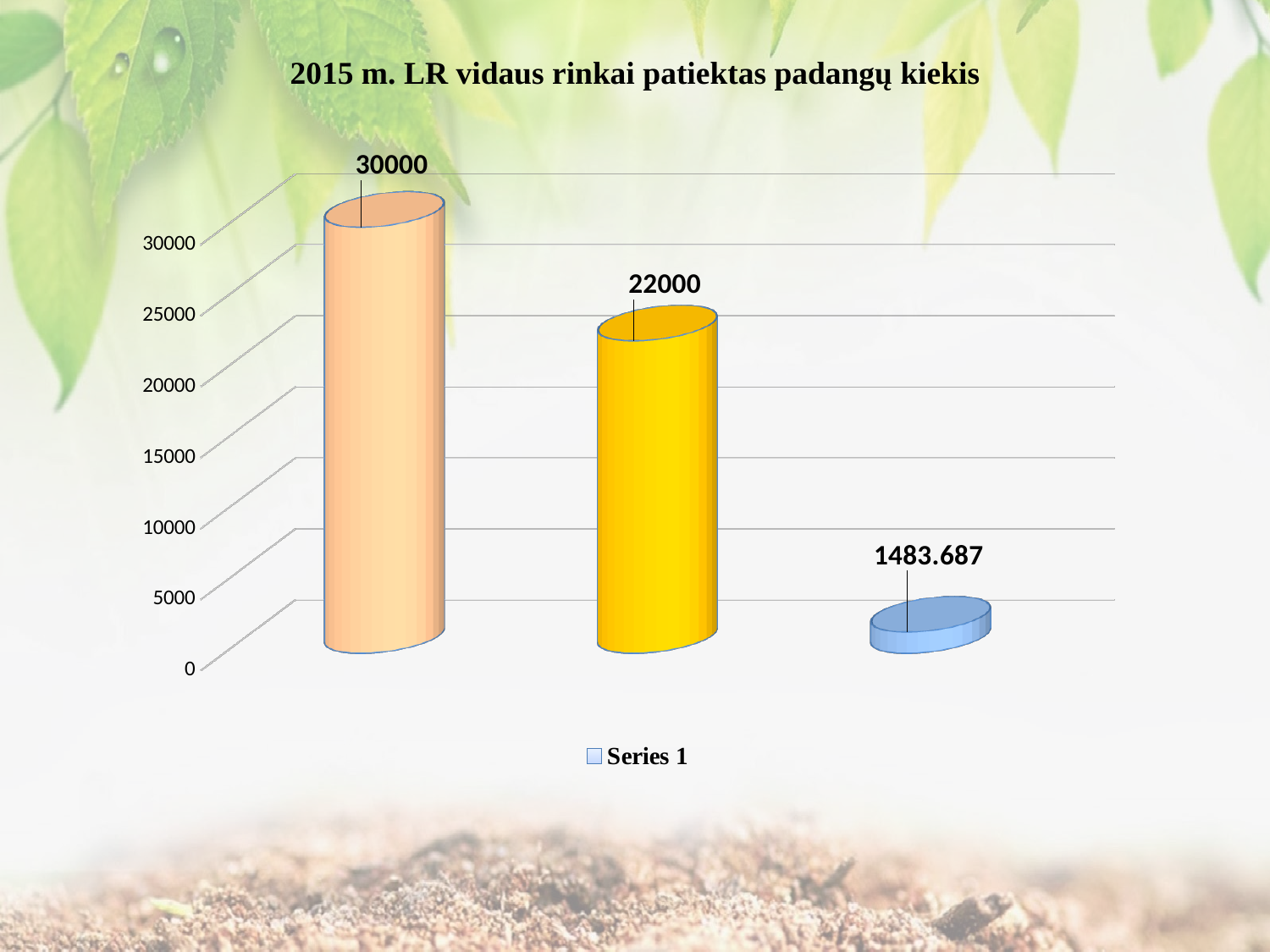
What is the value shown on the rightmost bar of the chart? 1483.687 Which is larger, the value of the middle bar or the value of the right bar? the middle bar Which bar has the highest value: the left, middle or right one? the left one Do the bar values rise or fall from left to right? fall What is the value shown on the leftmost bar of the chart? 30000 What is the difference between the values of the middle bar and the right bar? 20516.313 How many bars are plotted in the chart? 3 How many series does the legend list? 1 What kind of chart is shown on the slide? bar chart What is the value shown on the middle bar of the chart? 22000 What is the difference between the values of the left bar and the middle bar? 8000 Which bar has the lowest value: the left, middle or right one? the right one